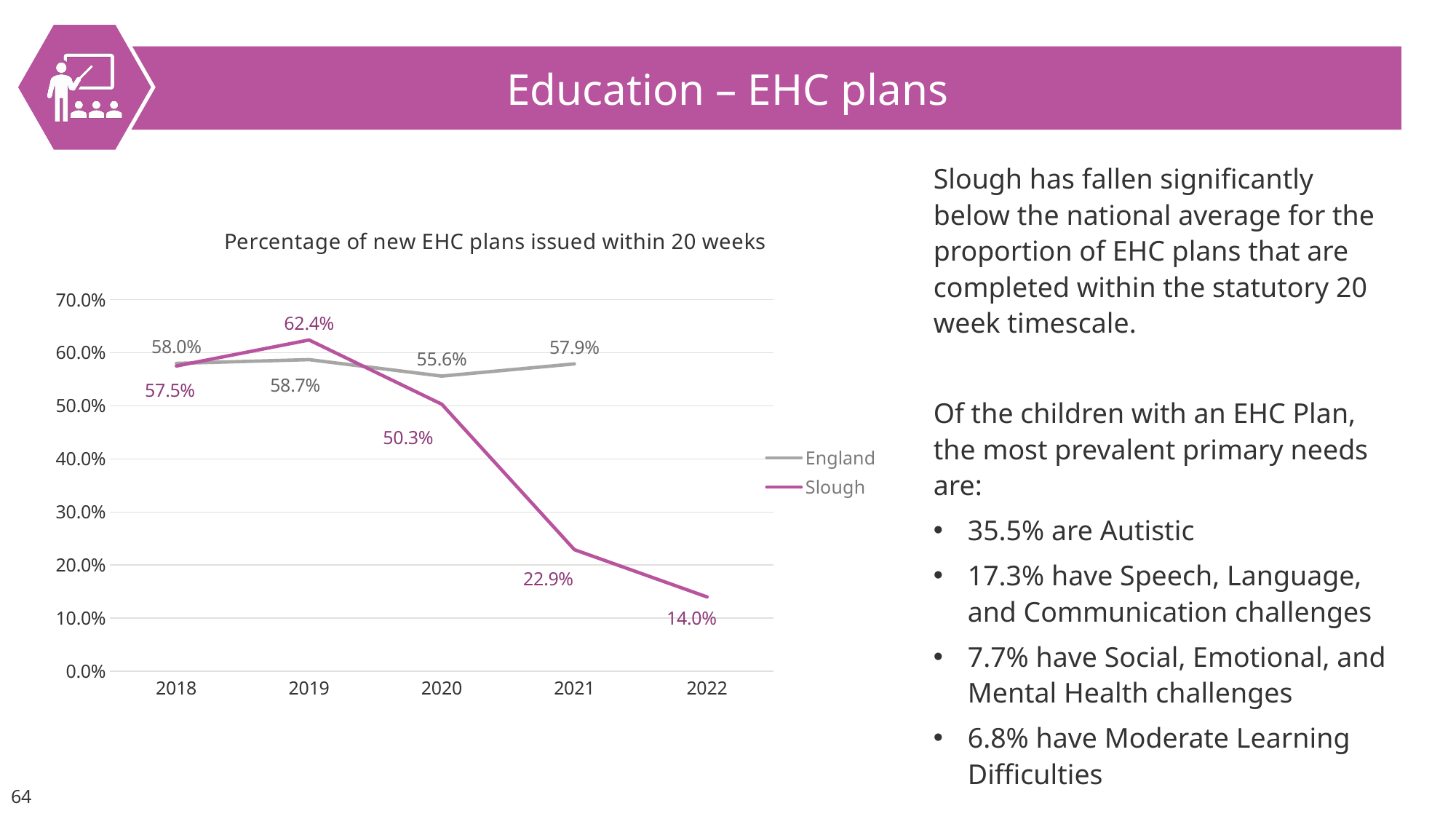
What was Slough's value in 2019? 62.4% What is the title of the chart? Percentage of new EHC plans issued within 20 weeks How many series does the chart legend list? 2 Which series had the higher value in 2019, England or Slough? Slough How many years are shown on the x axis? 5 What was England's value in 2020? 55.6% What is the difference between England's and Slough's values in 2021? 35.0% In which year was Slough's value lowest? 2022 How does Slough's value change from 2019 to 2022? It falls In which year was Slough's value highest? 2019 What type of chart is shown on the slide? Line chart What was Slough's value in 2022? 14.0%